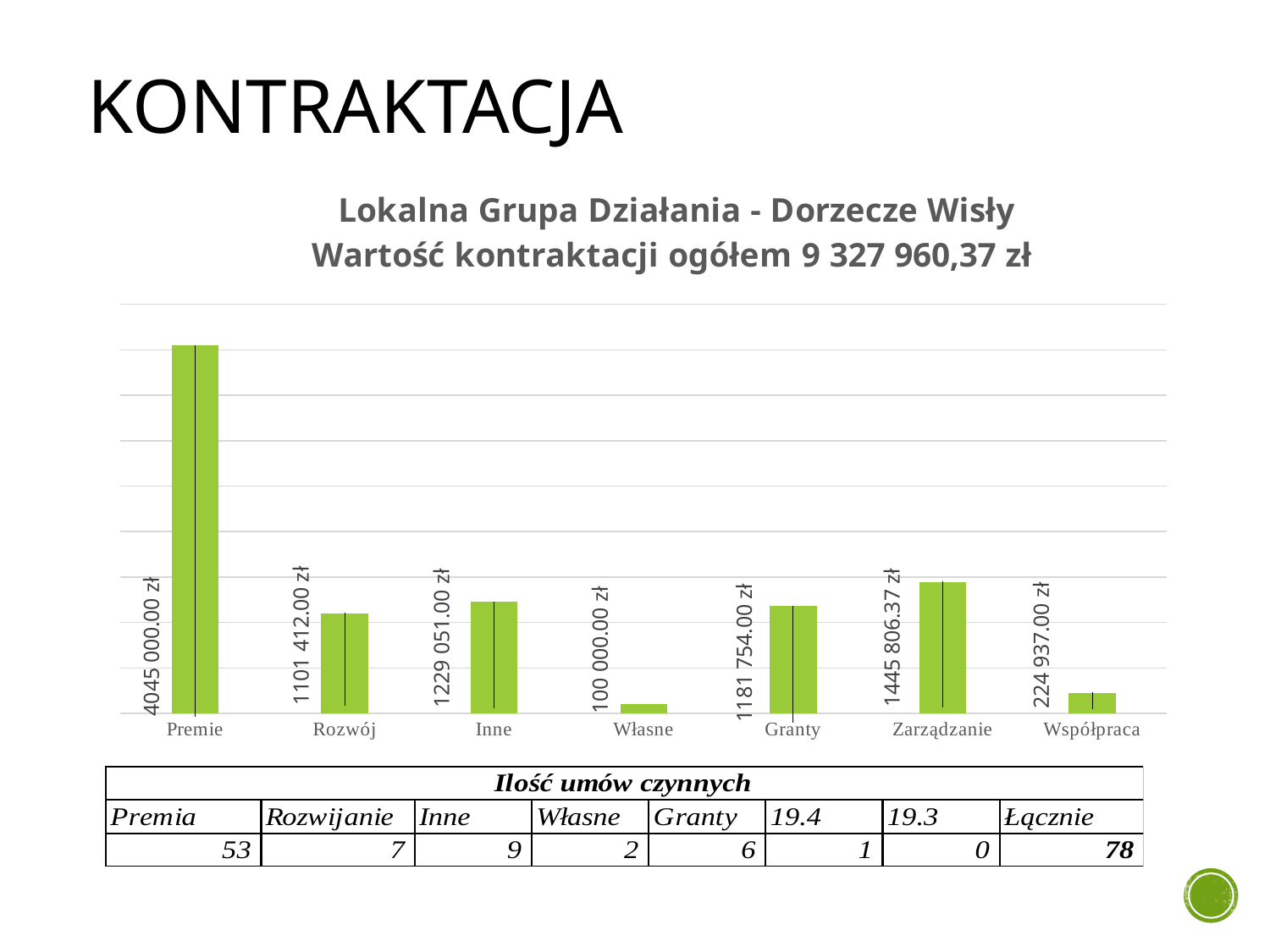
What is the value for Zarządzanie? 1445 806.37 zł What is the value for Granty? 1181 754.00 zł Which category has the highest value? Premie What total contract value is stated in the chart title? 9 327 960,37 zł What is the difference between the values for Premie and Własne? 3 945 000.00 zł How many categories are shown on the chart? 7 Which is larger, the value for Inne or the value for Granty? Inne What kind of chart is shown on the slide? Bar chart What is the value for Premie? 4045 000.00 zł What is the value for Współpraca? 224 937.00 zł What is the difference between the values for Zarządzanie and Rozwój? 344 394.37 zł Which category has the lowest value? Własne